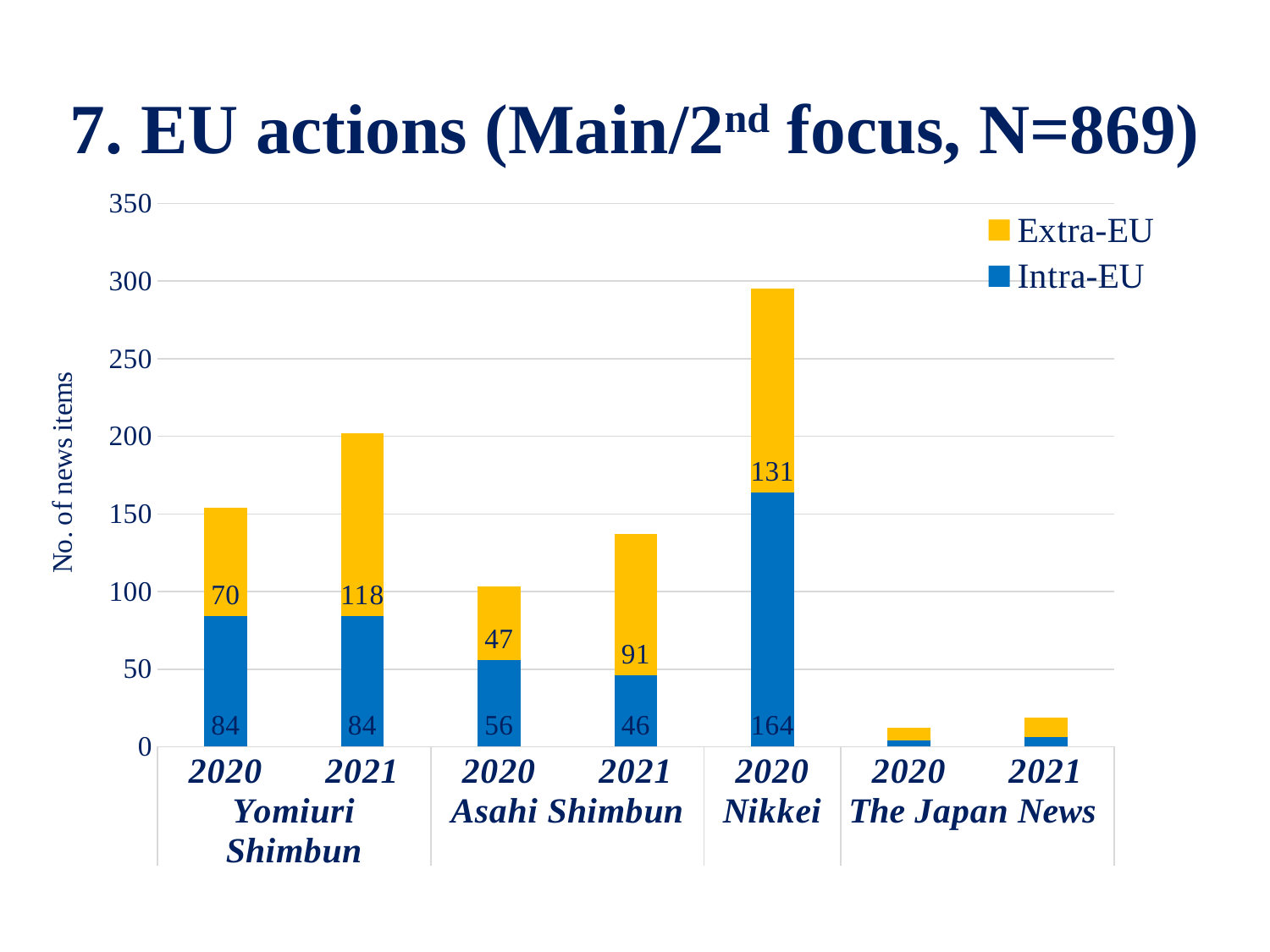
Which is larger, the Extra-EU value for Asahi Shimbun in 2021 or the Extra-EU value for Yomiuri Shimbun in 2020? Asahi Shimbun 2021 What is the total of the stacked bar for Asahi Shimbun in 2020? 103 What is the total of the stacked bar for Nikkei in 2020? 295 Among the bars with printed labels, which has the lowest Intra-EU value? Asahi Shimbun 2021 Which newspaper-year bar has the highest Extra-EU value? Nikkei 2020 What is the Extra-EU value for Yomiuri Shimbun in 2021? 118 What kind of chart is shown on the slide? Stacked bar chart How many series does the legend list? 2 What is the Intra-EU value for Asahi Shimbun in 2021? 46 Is the total height of the bar for The Japan News in 2021 greater or less than 50? less What is the Intra-EU value for Nikkei in 2020? 164 What is the difference between the Extra-EU values for Yomiuri Shimbun in 2021 and 2020? 48